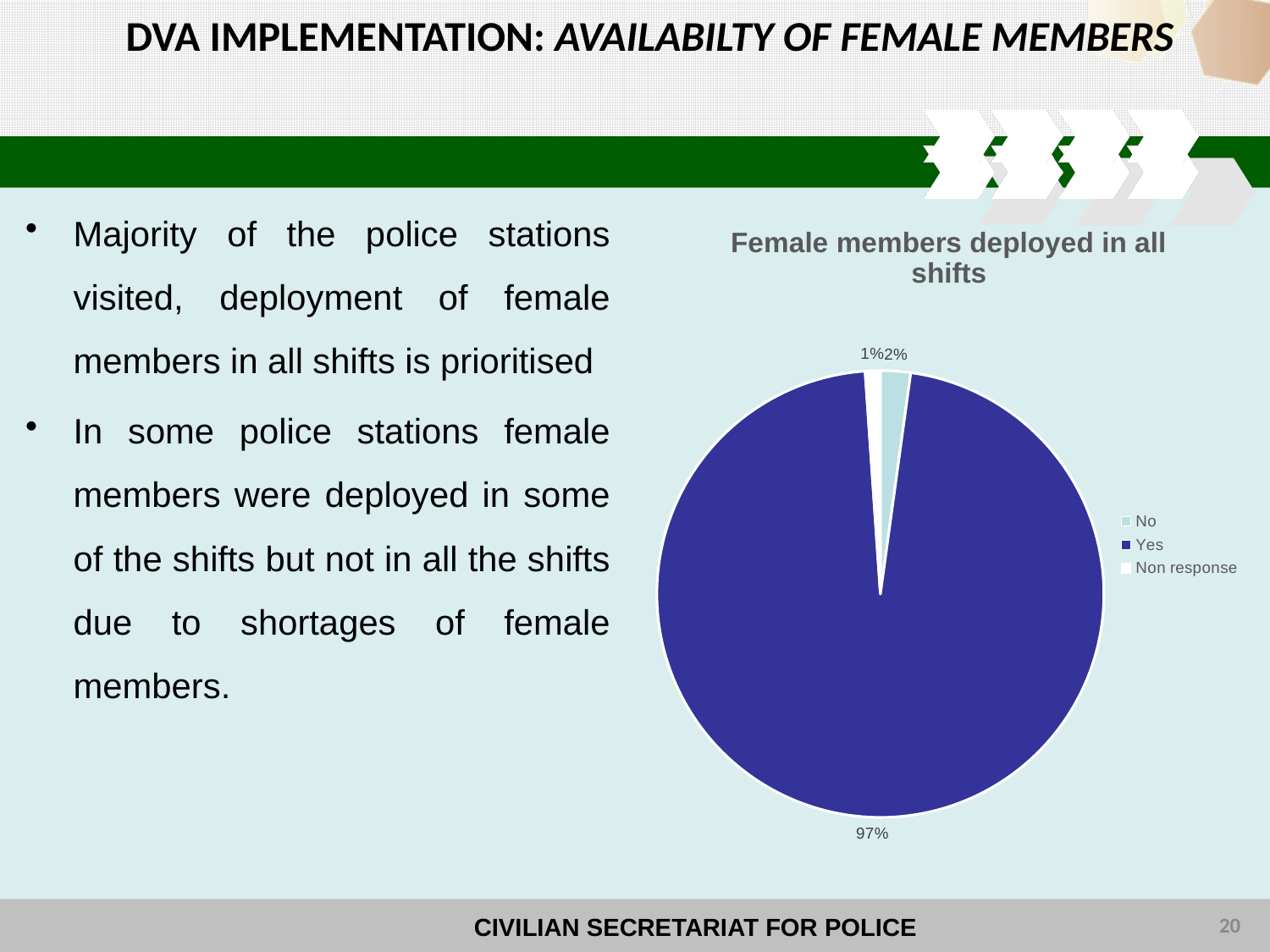
Which category has the smallest slice of the pie? Non response How many categories does the legend of the pie chart list? 3 How many slices does the pie chart have? 3 What share of the pie is labelled for 'Yes'? 97% What share of the pie is labelled for 'No'? 2% What is the title of the chart? Female members deployed in all shifts Which is larger, the slice for 'Yes' or the slice for 'No'? Yes Which legend entry is shown in dark blue? Yes What is the difference in percentage points between the 'Yes' slice and the 'No' slice? 95 What share of the pie is labelled for 'Non response'? 1% Which category has the largest slice of the pie? Yes What kind of chart is shown on the slide? pie chart